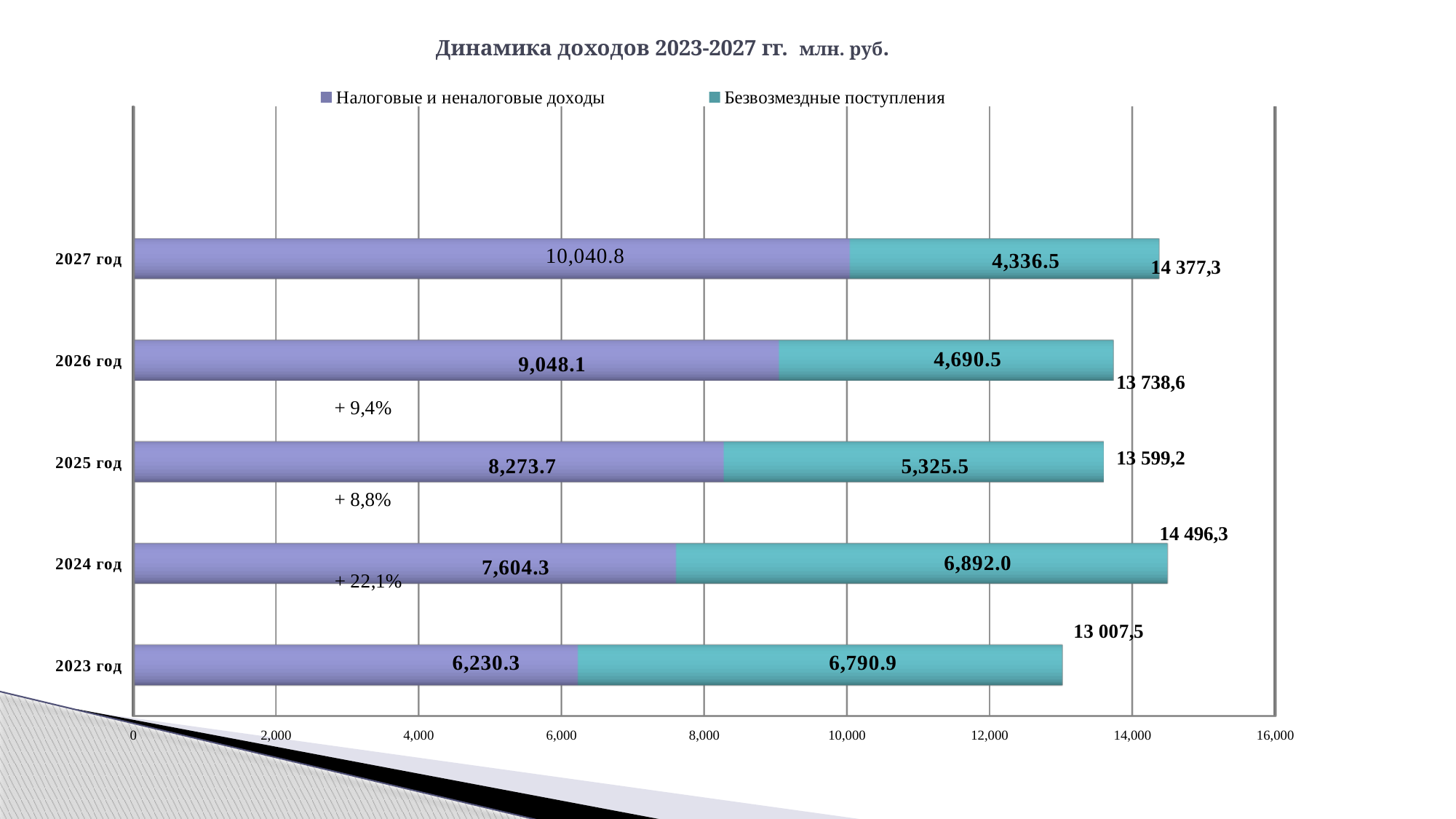
Which is larger for 2023 год: Налоговые и неналоговые доходы or Безвозмездные поступления? Безвозмездные поступления What is the difference between Налоговые и неналоговые доходы in 2026 год and 2025 год? 774.4 What is the total of the stacked bar for 2024 год? 14 496,3 Which year has the lowest value of Безвозмездные поступления? 2027 год Do the values of Налоговые и неналоговые доходы rise or fall from 2023 год to 2027 год? Rise How many years are shown on the chart? 5 What is the value of Налоговые и неналоговые доходы for 2027 год? 10,040.8 What kind of chart is shown on the slide? Stacked bar chart Which year has the highest value of Налоговые и неналоговые доходы? 2027 год What is the value of Налоговые и неналоговые доходы for 2023 год? 6,230.3 How many series does the legend list? 2 What is the value of Безвозмездные поступления for 2024 год? 6,892.0